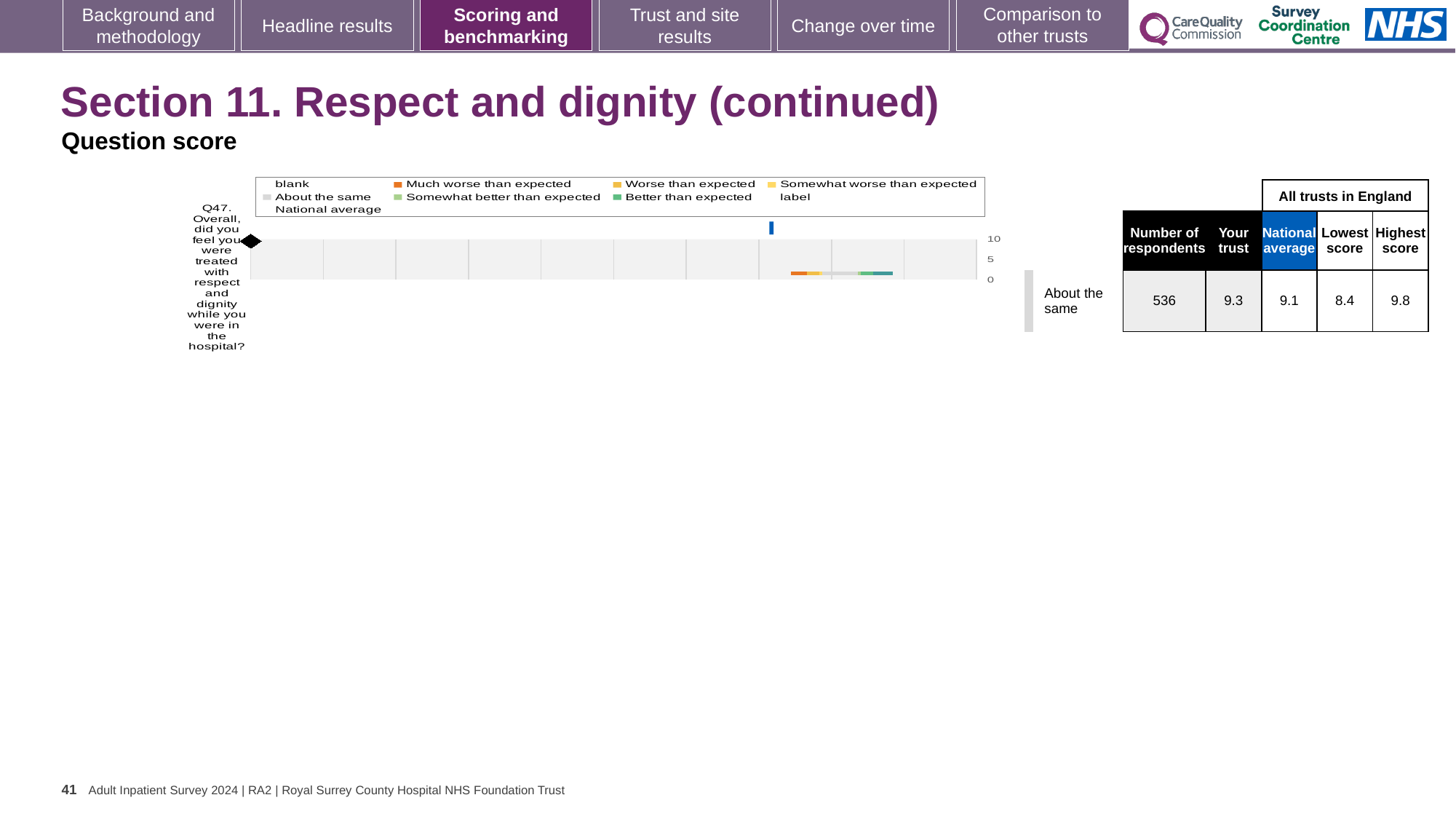
Which question is plotted on the chart? Q47. Overall, did you feel you were treated with respect and dignity while you were in the hospital? What is the highest tick value shown on the chart's score axis? 10 What kind of chart is shown on the slide? bar chart How many question categories are plotted on the chart? 1 How many entries does the chart's legend list? 9 What colour does the legend use for 'Much worse than expected'? orange